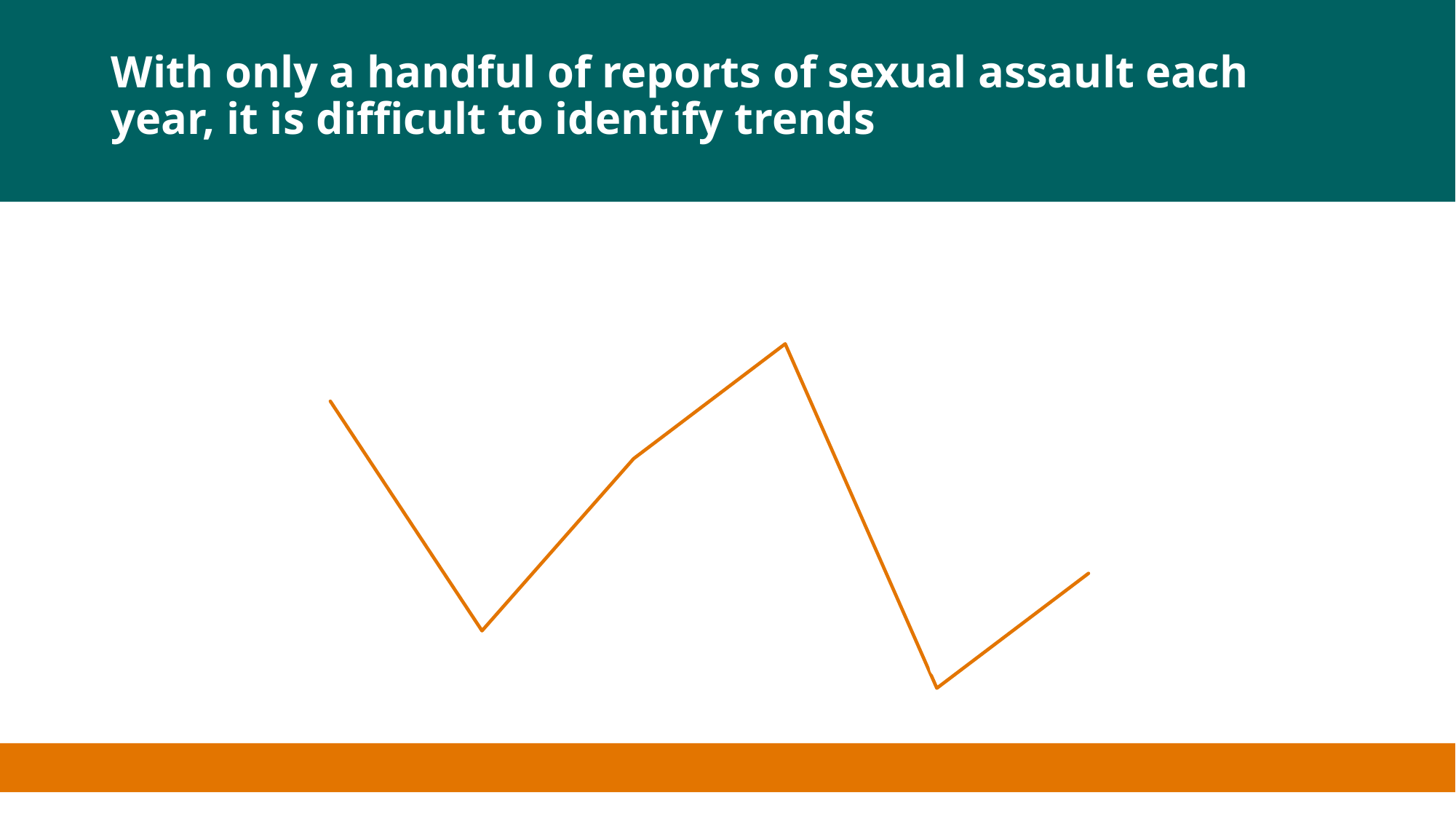
How many lines are plotted on the chart? 1 What kind of chart is shown on the slide? line chart Does the line rise or fall between its first and second points? fall Does the chart display any axis labels or data labels? No Is the last point of the line higher or lower than the first point? lower What colour is the line on the chart? orange How many data points does the line on the chart connect? 6 Which point of the line is the highest: the fourth or the first? the fourth Which point of the line is the lowest: the second or the fifth? the fifth Does the line rise or fall between its fifth and sixth points? rise